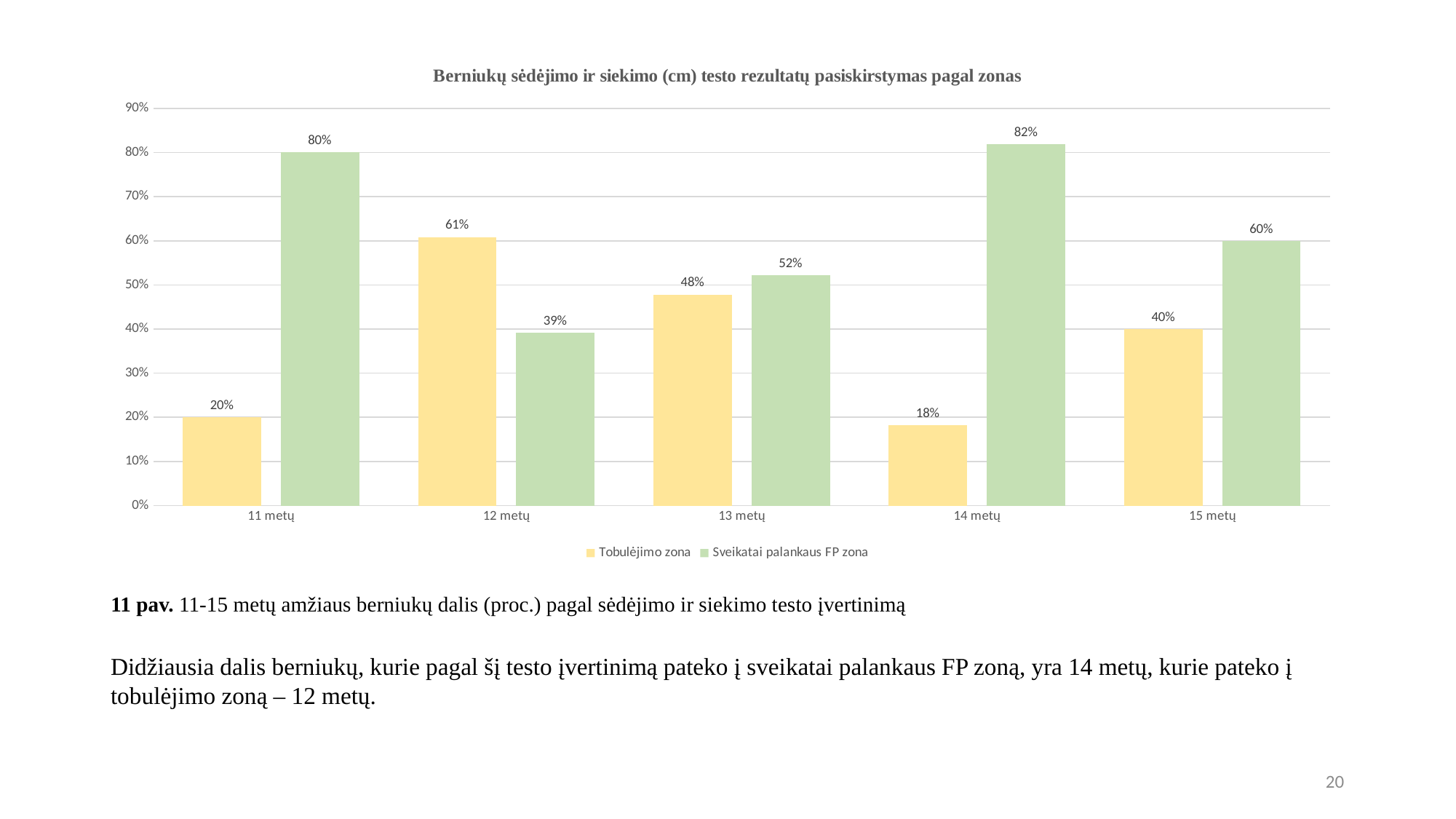
What is the difference between the Sveikatai palankaus FP zona and Tobulėjimo zona values at 11 metų? 60% At 12 metų, which series has the larger value: Tobulėjimo zona or Sveikatai palankaus FP zona? Tobulėjimo zona What is the title of the chart? Berniukų sėdėjimo ir siekimo (cm) testo rezultatų pasiskirstymas pagal zonas How many age groups are shown on the x axis? 5 Is the value for Sveikatai palankaus FP zona at 13 metų greater or less than 50%? greater How many series does the legend list? 2 Which age group has the lowest value for Tobulėjimo zona? 14 metų What is the value for Tobulėjimo zona at 15 metų? 40% What is the value for Sveikatai palankaus FP zona at 14 metų? 82% What kind of chart is shown on the slide? Bar chart What is the value for Tobulėjimo zona at 11 metų? 20% Which age group has the highest value for Sveikatai palankaus FP zona? 14 metų